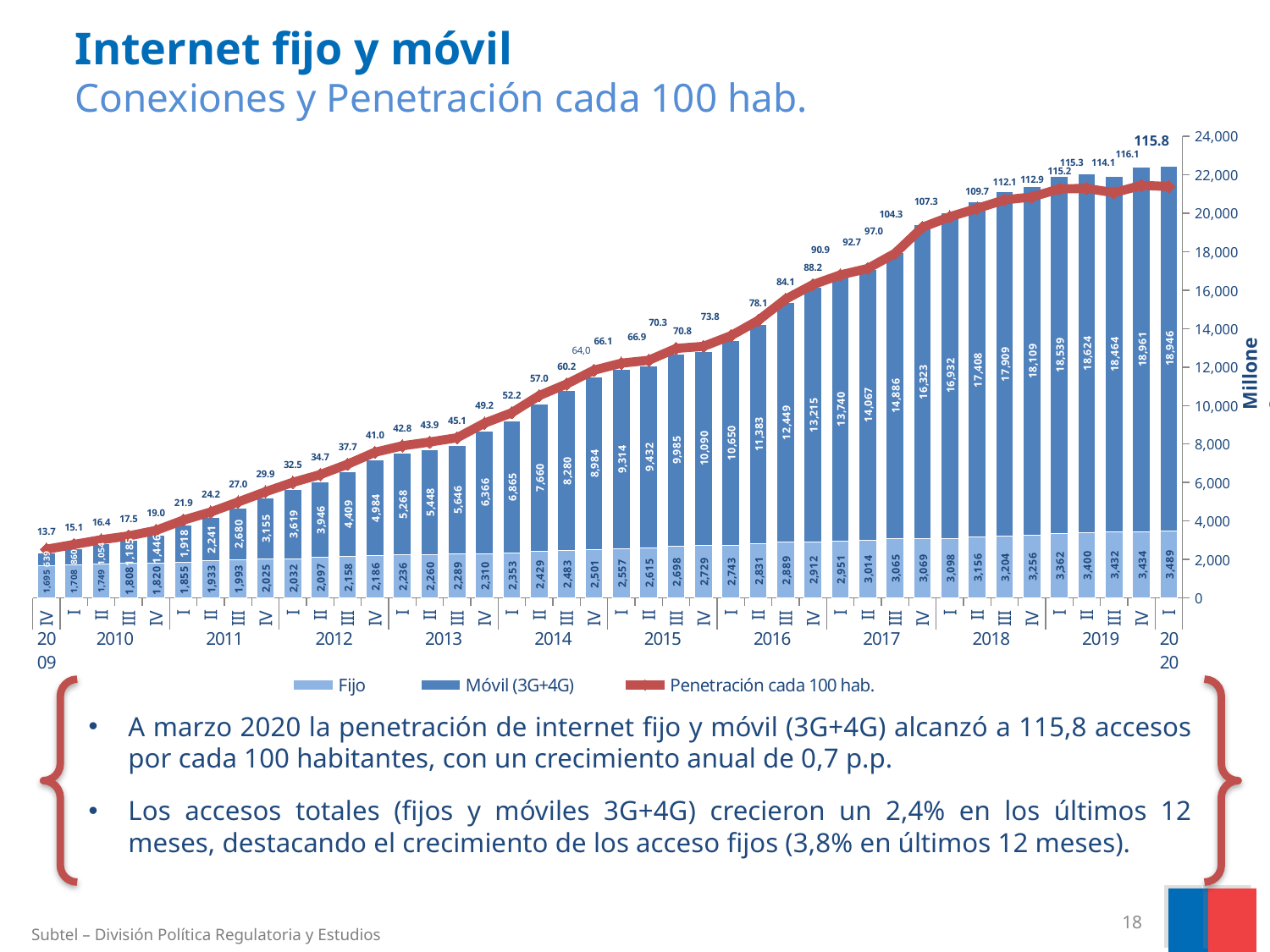
What is the Fijo value for IV 2009? 1,695 What is the Fijo value for I 2020? 3,489 What is the difference between the Fijo value for I 2020 and the Fijo value for I 2019? 127 What is the total of the stacked bar (Fijo plus Móvil) for I 2020? 22,435 In which quarter is Penetración cada 100 hab. lowest? IV 2009 What is the Penetración cada 100 hab. value for I 2015? 66.1 Does Penetración cada 100 hab. generally rise or fall from IV 2009 to I 2020? Rise What is the value of Penetración cada 100 hab. for I 2020? 115.8 In which quarter is Penetración cada 100 hab. highest? IV 2019 What is the Móvil (3G+4G) value for I 2020? 18,946 What kind of chart is shown on the slide? Stacked bar chart with a line How many series does the legend list? 3